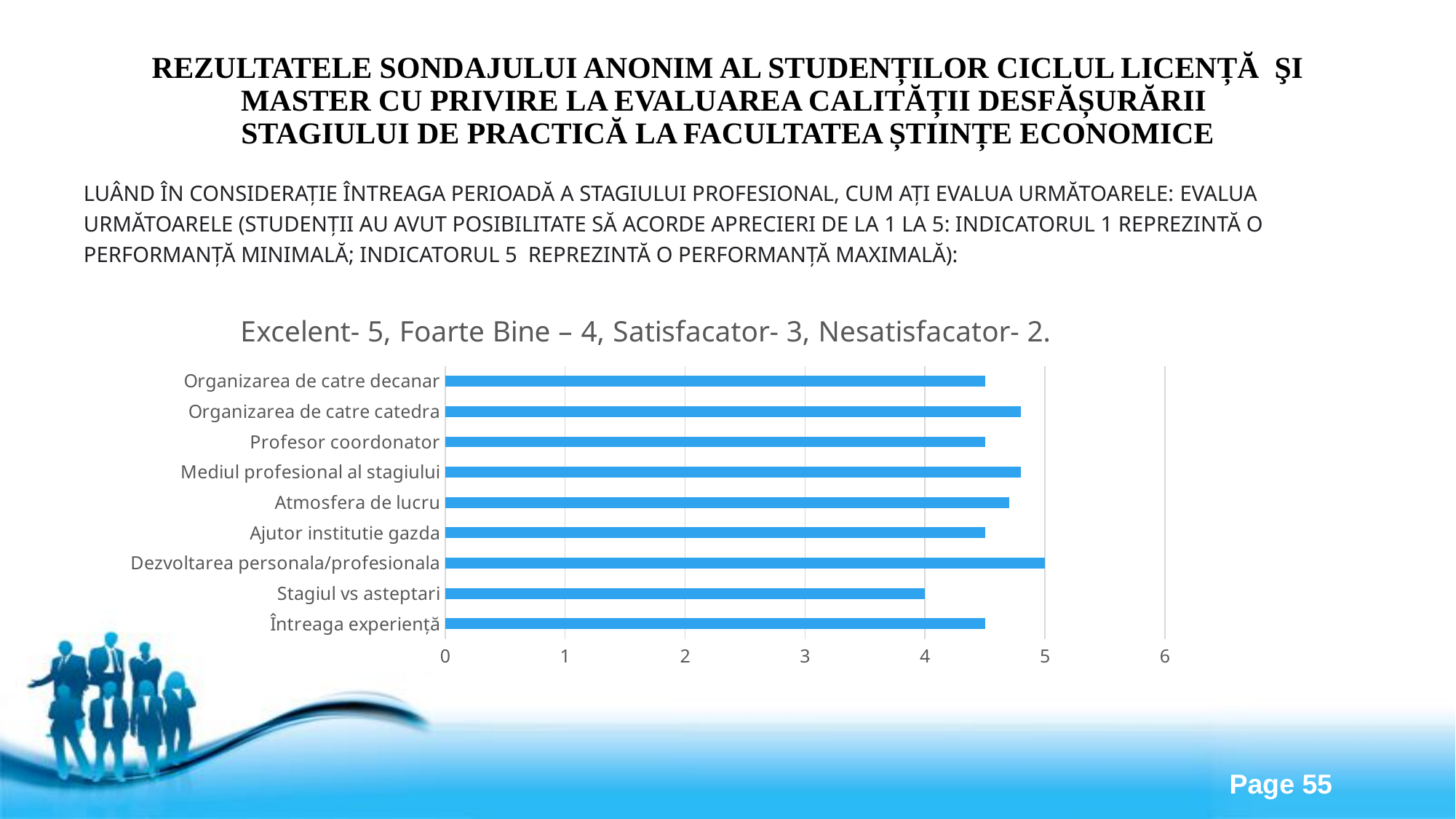
What is the value for Stagiul vs asteptari? 4 What is the value for Dezvoltarea personala/profesionala? 5 What is the highest value shown on the horizontal axis of the chart? 6 Which category has the lowest value in the chart? Stagiul vs asteptari How many categories are plotted in the chart? 9 What kind of chart is shown on the slide? Bar chart Is the value for Mediul profesional al stagiului greater or less than 4? greater What is the title of the chart? Excelent- 5, Foarte Bine – 4, Satisfacator- 3, Nesatisfacator- 2. Which is larger, the value for Organizarea de catre catedra or the value for Stagiul vs asteptari? Organizarea de catre catedra Is the value for Organizarea de catre decanar greater or less than 4? greater Which category has the highest value in the chart? Dezvoltarea personala/profesionala Is the value for Atmosfera de lucru greater or less than 5? less